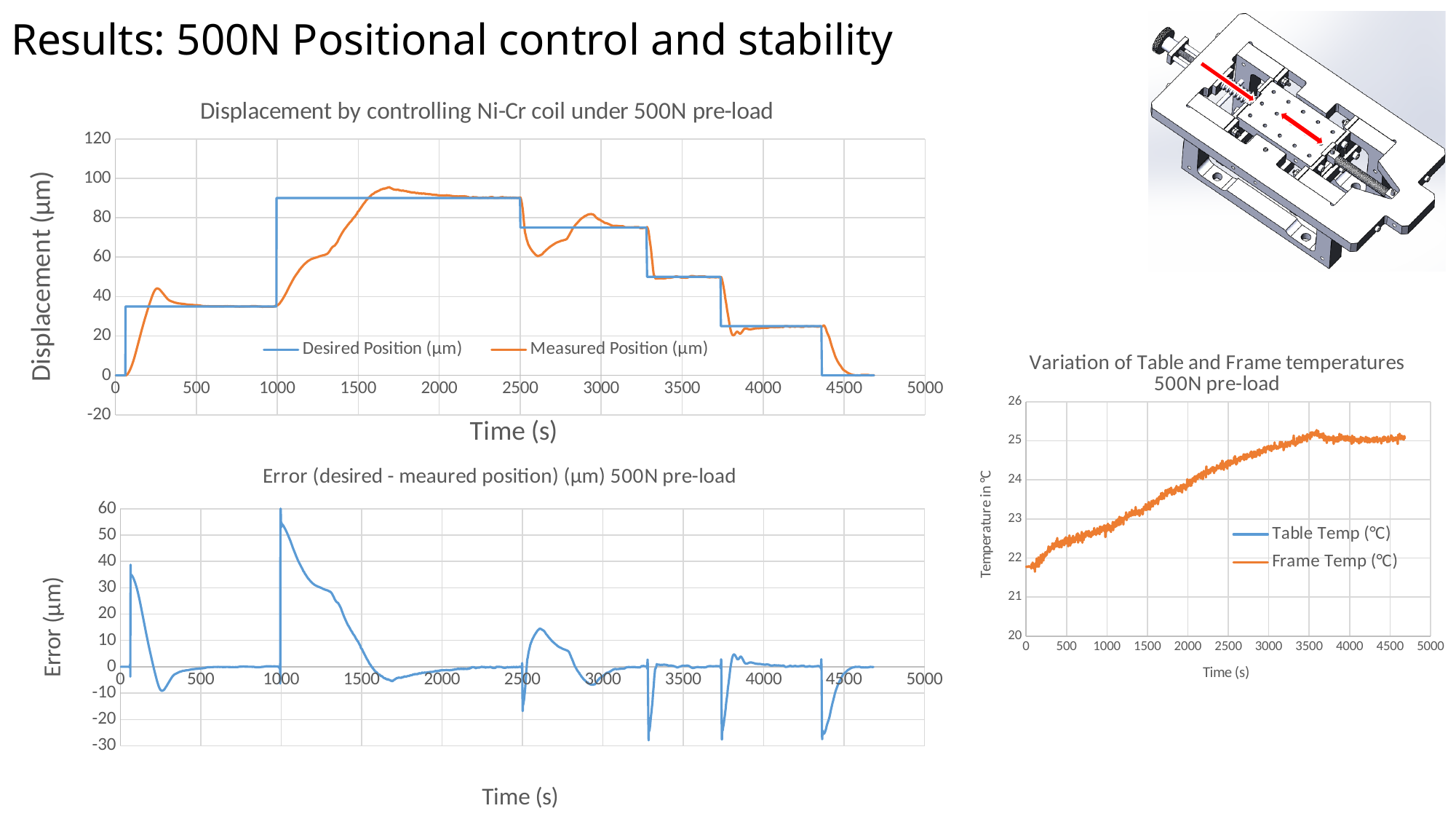
What kind of chart is the 'Displacement by controlling Ni-Cr coil under 500N pre-load' chart? line chart What is the y-axis title of the 'Variation of Table and Frame temperatures 500N pre-load' chart? Temperature in ℃ In the 'Error (desired - meaured position) (µm) 500N pre-load' chart, is the lowest error near 3300 s greater or less than -20? less How many series does the legend of the 'Variation of Table and Frame temperatures 500N pre-load' chart list? 2 In the 'Displacement by controlling Ni-Cr coil under 500N pre-load' chart, is the Desired Position between 3800 s and 4300 s greater or less than 40? less In the 'Variation of Table and Frame temperatures 500N pre-load' chart, does the temperature generally rise or fall from 0 s to 3500 s? rise How many series does the legend of the 'Displacement by controlling Ni-Cr coil under 500N pre-load' chart list? 2 In the 'Error (desired - meaured position) (µm) 500N pre-load' chart, is the peak error at about 1000 s greater or less than 50? greater What kind of chart is the 'Error (desired - meaured position) (µm) 500N pre-load' chart? line chart In the 'Displacement by controlling Ni-Cr coil under 500N pre-load' chart, what are the two legend entries? Desired Position (µm) and Measured Position (µm)